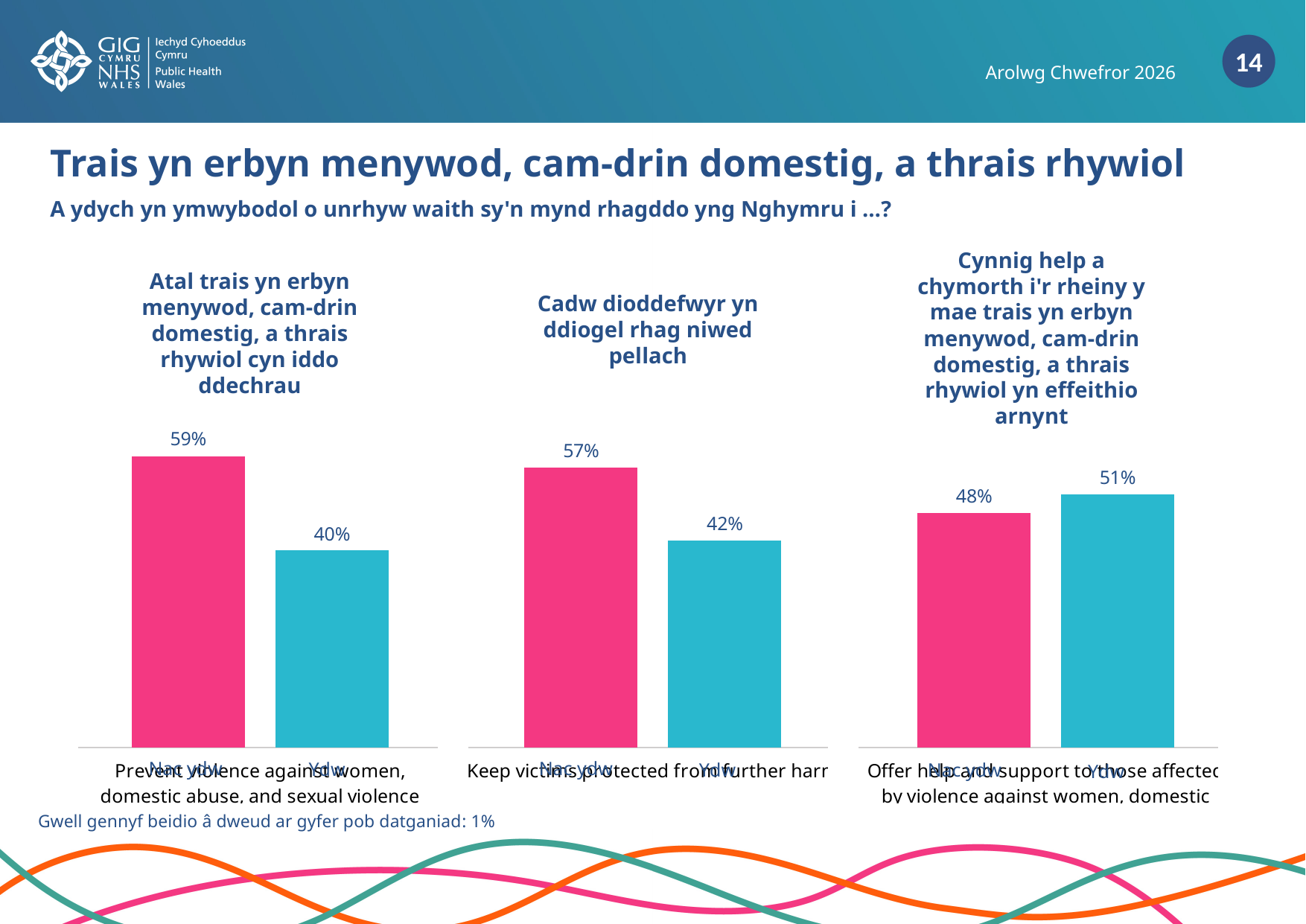
In the right chart (Cynnig help a chymorth...), what is the value of the pink bar? 48% In the middle chart (Cadw dioddefwyr yn ddiogel rhag niwed pellach), what is the difference between the two bars? 15 percentage points In the left chart (Atal trais yn erbyn menywod...), what is the value of the right teal bar? 40% In the middle chart (Cadw dioddefwyr yn ddiogel rhag niwed pellach), which bar is higher, the pink bar or the teal bar? the pink bar How many bars does each of the three charts on the slide have? 2 In the middle chart (Cadw dioddefwyr yn ddiogel rhag niwed pellach), what is the value of the teal bar? 42% In the middle chart (Cadw dioddefwyr yn ddiogel rhag niwed pellach), what is the value of the pink bar? 57% In the left chart (Atal trais yn erbyn menywod, cam-drin domestig, a thrais rhywiol cyn iddo ddechrau), what is the value of the left pink bar? 59% In the right chart (Cynnig help a chymorth...), what is the value of the teal bar? 51% In the right chart (Cynnig help a chymorth...), which bar is higher, the pink bar or the teal bar? the teal bar What type of chart is used on this slide? bar chart In the left chart (Atal trais yn erbyn menywod...), what is the difference between the pink bar and the teal bar? 19 percentage points